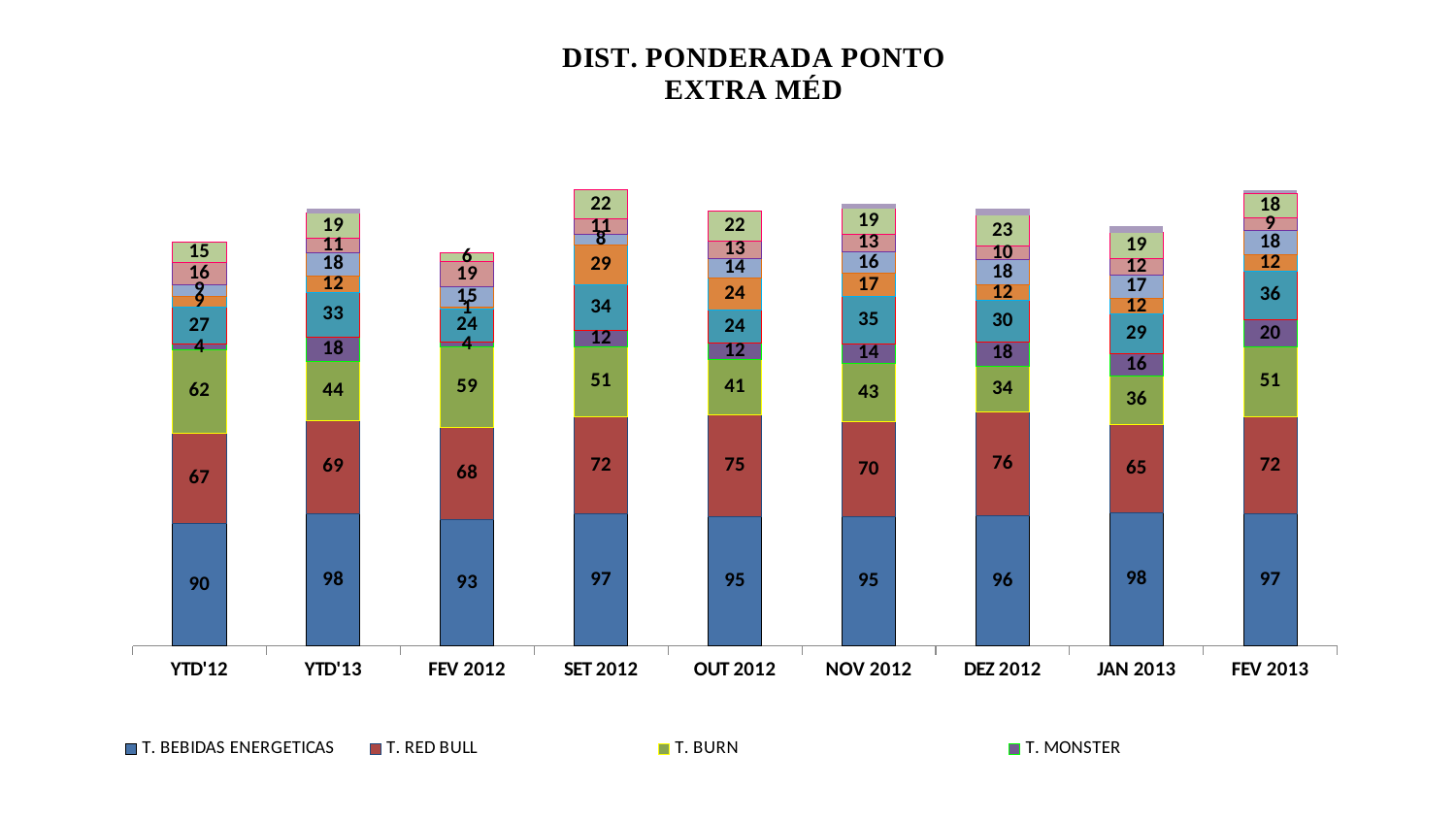
How many categories are shown on the x axis of the chart? 9 How many series does the chart's legend list? 4 In which category is T. BURN lowest? DEZ 2012 What is the title of the chart? DIST. PONDERADA PONTO EXTRA MÉD What is the value of T. BURN for SET 2012? 51 What is the value of T. MONSTER for FEV 2013? 20 What is the value of T. BEBIDAS ENERGETICAS for YTD'12? 90 What type of chart is shown on the slide? Stacked bar chart What is the difference between the T. RED BULL values for DEZ 2012 and JAN 2013? 11 What is the value of T. RED BULL for OUT 2012? 75 In which category is T. RED BULL highest? DEZ 2012 Which is larger, the T. BURN value for FEV 2012 or for FEV 2013? FEV 2012